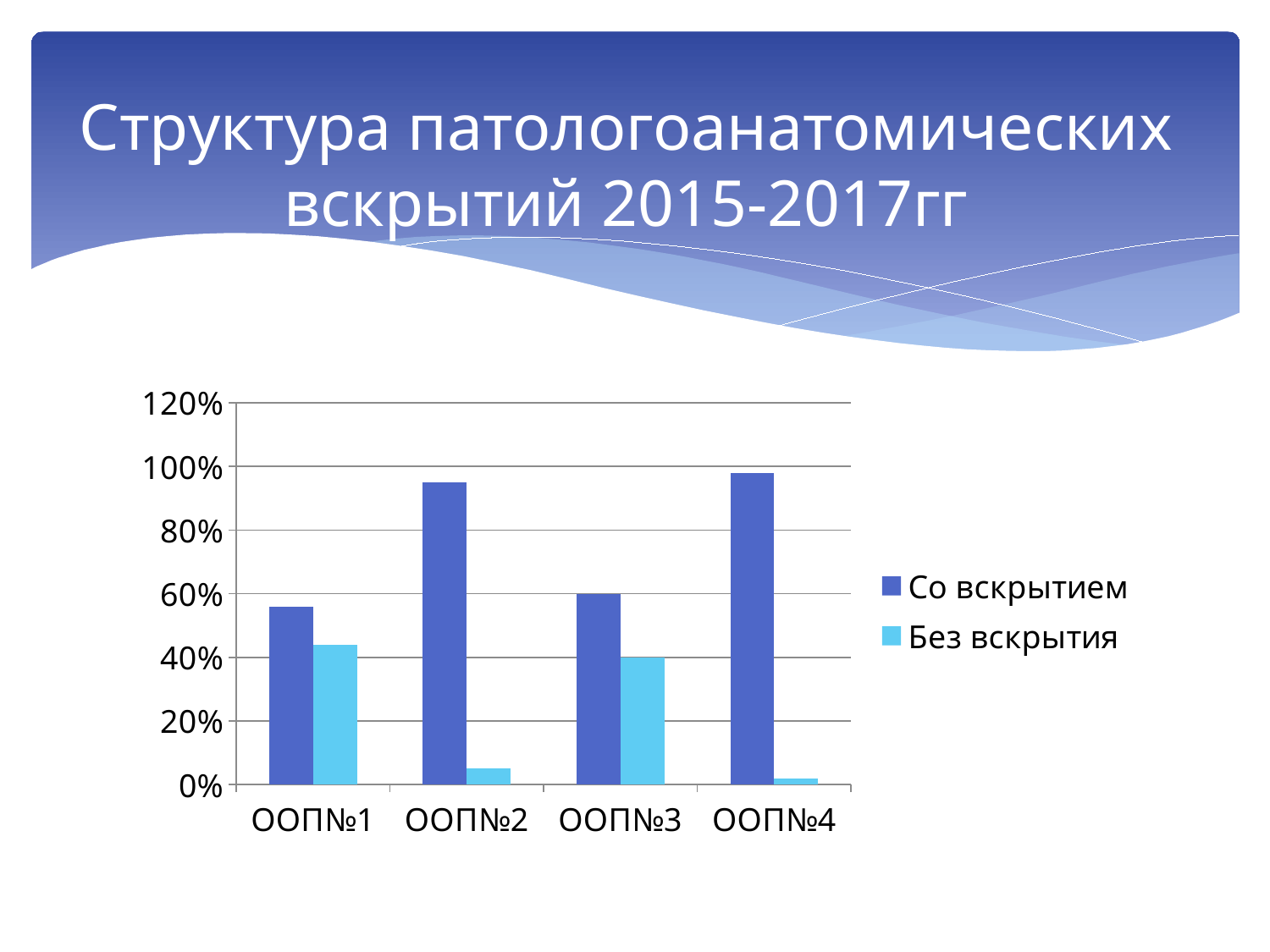
Which is larger in ООП№3: "Со вскрытием" or "Без вскрытия"? Со вскрытием What is the title of the slide containing the chart? Структура патологоанатомических вскрытий 2015-2017гг What kind of chart is shown on the slide? bar chart Which category has the lowest value for "Со вскрытием"? ООП№1 Is the value for "Со вскрытием" in ООП№2 greater or less than 80%? greater Which category has the highest value for "Без вскрытия"? ООП№1 Is the value for "Без вскрытия" in ООП№2 greater or less than 20%? less How many series does the chart legend list? 2 How many categories are shown on the x axis of the chart? 4 Which category has the highest value for "Со вскрытием"? ООП№4 Which category has the lowest value for "Без вскрытия"? ООП№4 Is the value for "Со вскрытием" in ООП№1 greater or less than 40%? greater